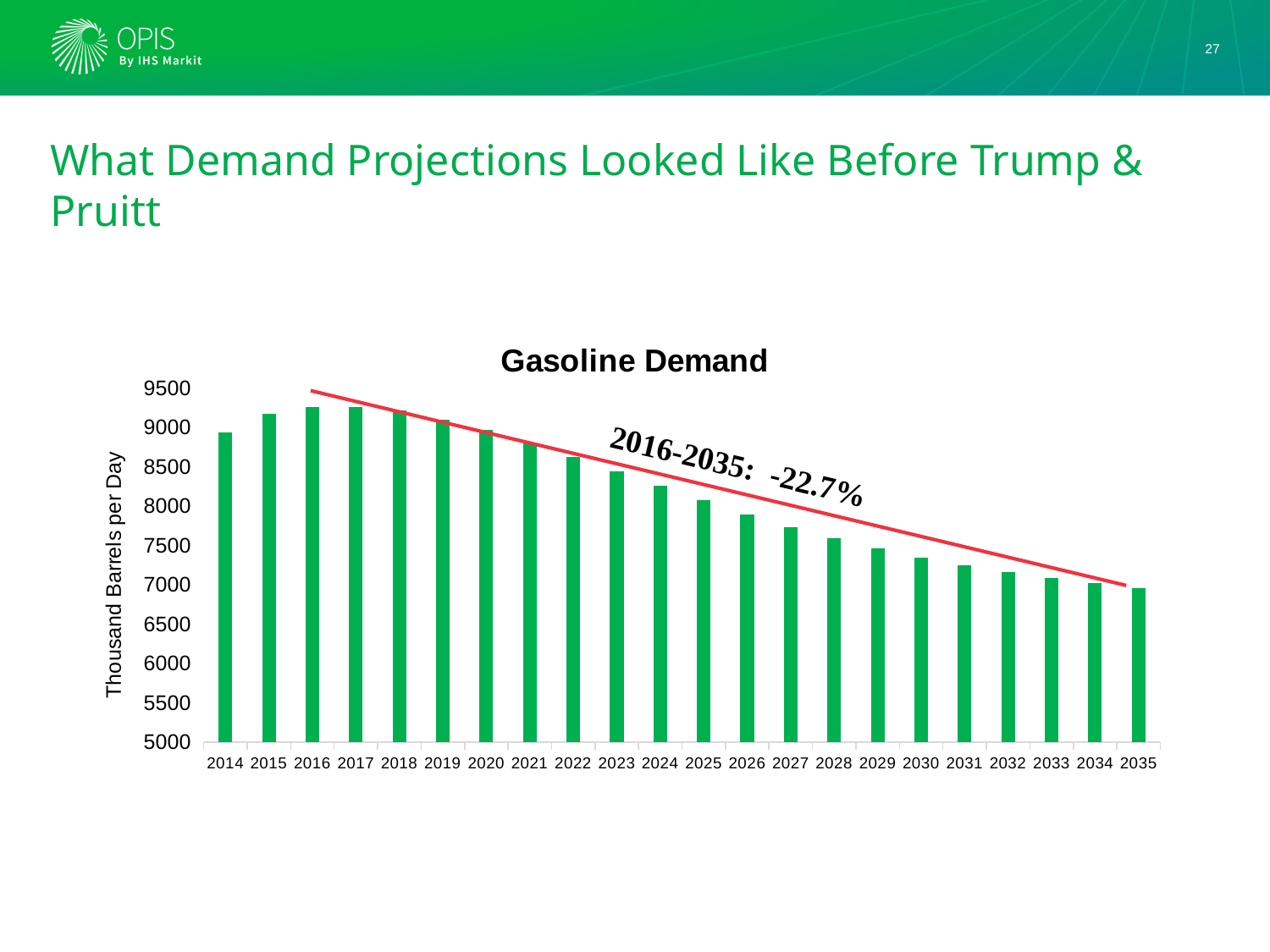
Is the value for 2030 greater or less than 7500? less Which is larger, the value for 2014 or the value for 2035? 2014 Which is larger, the value for 2022 or the value for 2028? 2022 How many years are plotted on the chart? 22 Is the value for 2031 greater or less than 7000? greater What is the label on the vertical axis of the chart? Thousand Barrels per Day What kind of chart is shown on the slide? bar chart Is the value for 2026 greater or less than 8000? less Do the values generally rise or fall from 2017 to 2035? fall What is the title of the chart? Gasoline Demand